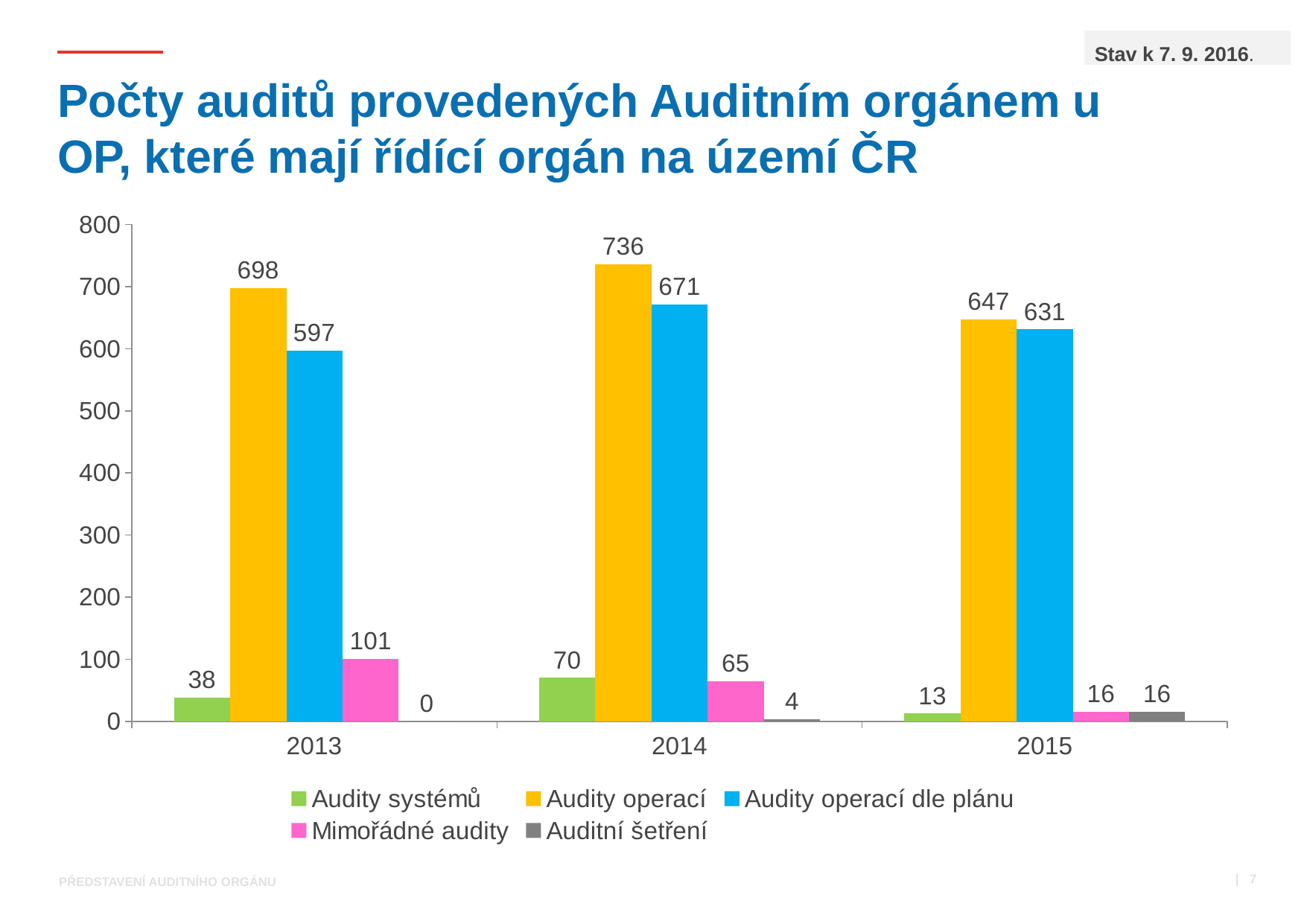
What is the value of Audity operací in 2014? 736 What is the value of Mimořádné audity in 2015? 16 What kind of chart is shown on the slide? Bar chart How many years are shown on the x axis? 3 Which is larger in 2015: Audity operací or Audity operací dle plánu? Audity operací What is the difference between Audity operací and Audity operací dle plánu in 2013? 101 In which year is Audity operací dle plánu highest? 2014 Does Mimořádné audity rise or fall from 2013 to 2015? Fall How many series does the legend list? 5 What is the value of Auditní šetření in 2013? 0 What is the value of Audity systémů in 2013? 38 In which year is Audity systémů lowest? 2015